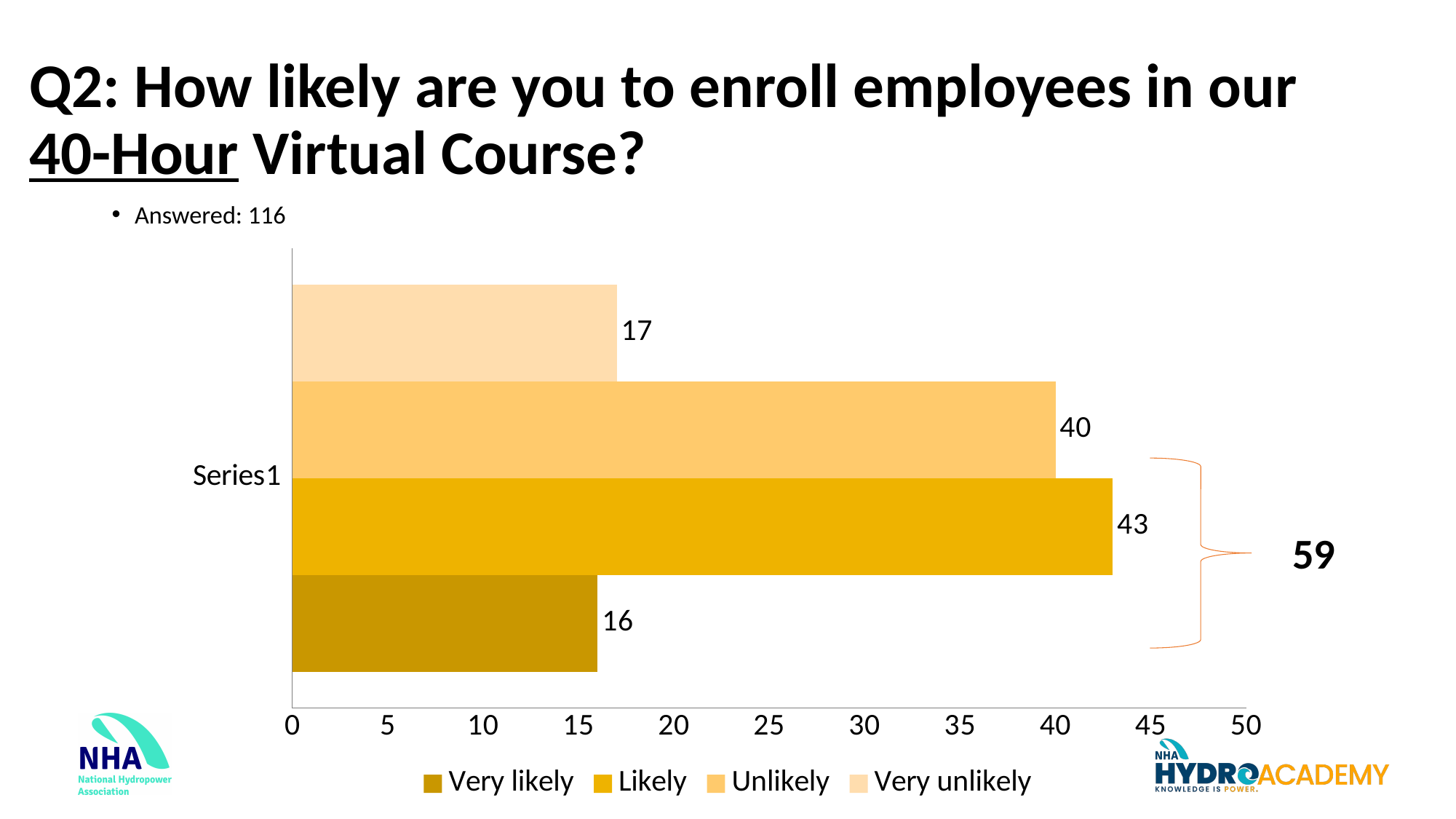
What is the value for Likely? 43 Which series has the highest value? Likely Which series has the lowest value? Very likely What is the value for Very unlikely? 17 How many series does the legend list? 4 What is the difference between the Likely and Unlikely values? 3 What kind of chart is shown on the slide? Bar chart Which is larger, the value for Very unlikely or the value for Very likely? Very unlikely What is the value for Very likely? 16 What is the value for Unlikely? 40 What combined total is shown by the bracket next to the Very likely and Likely bars? 59 How many respondents answered the question, according to the slide? 116